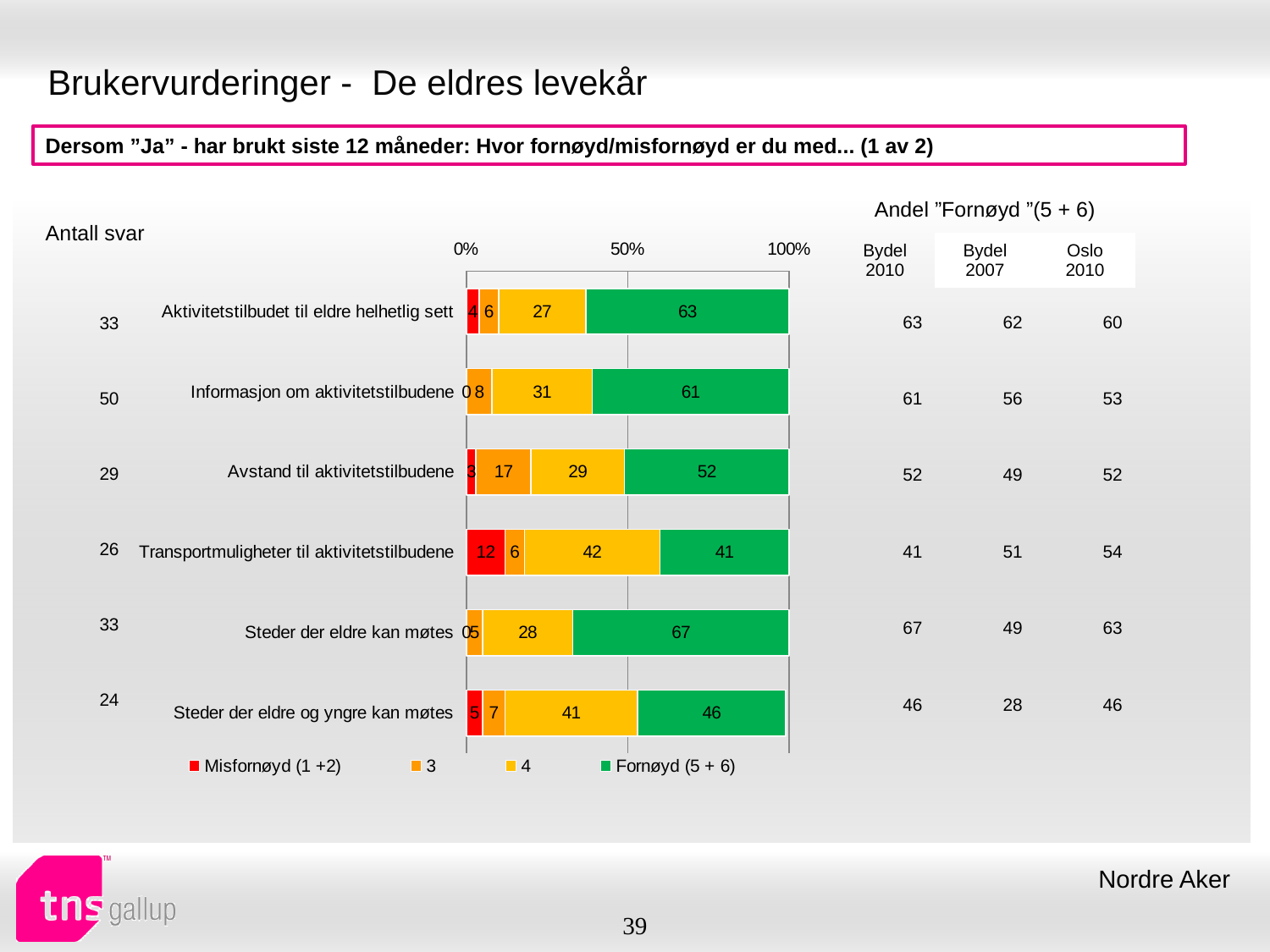
How many series does the chart legend list? 4 What is the value of series 4 for Steder der eldre og yngre kan møtes? 41 What is the Fornøyd (5 + 6) value for Aktivitetstilbudet til eldre helhetlig sett? 63 What is the difference between the Fornøyd (5 + 6) values for Steder der eldre kan møtes and Steder der eldre og yngre kan møtes? 21 How many categories are plotted in the chart? 6 What is the Misfornøyd (1 +2) value for Transportmuligheter til aktivitetstilbudene? 12 Which has a larger Fornøyd (5 + 6) value: Informasjon om aktivitetstilbudene or Avstand til aktivitetstilbudene? Informasjon om aktivitetstilbudene What is the total of the stacked bar for Transportmuligheter til aktivitetstilbudene? 101 Which category has the lowest Fornøyd (5 + 6) value? Transportmuligheter til aktivitetstilbudene What is the value of series 3 for Avstand til aktivitetstilbudene? 17 What kind of chart is shown on the slide? Stacked bar chart Which category has the highest Fornøyd (5 + 6) value? Steder der eldre kan møtes